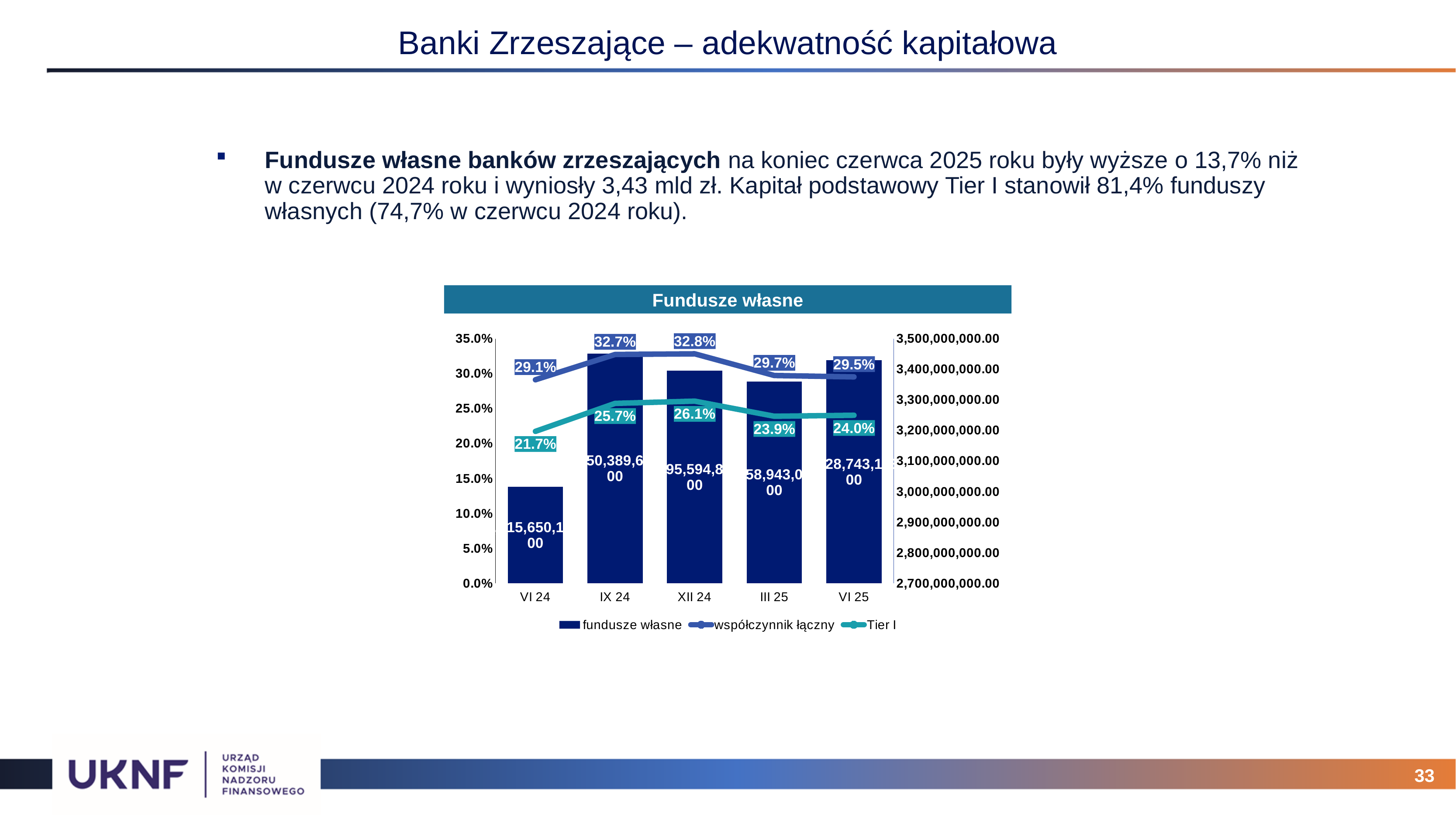
In which period is the współczynnik łączny lowest? VI 24 What is the Tier I value for VI 25? 24.0% What is the Tier I value for VI 24? 21.7% Is the fundusze własne bar for VI 24 greater or less than 3,100,000,000.00? less How many series does the legend list? 3 What is the współczynnik łączny value for IX 24? 32.7% What is the współczynnik łączny value for III 25? 29.7% What is the difference between współczynnik łączny and Tier I in VI 25? 5.5 percentage points In which period is the Tier I ratio highest? XII 24 How many periods are shown on the x axis? 5 Is the fundusze własne bar for III 25 greater or less than 3,200,000,000.00? greater Which period has the lowest fundusze własne bar? VI 24